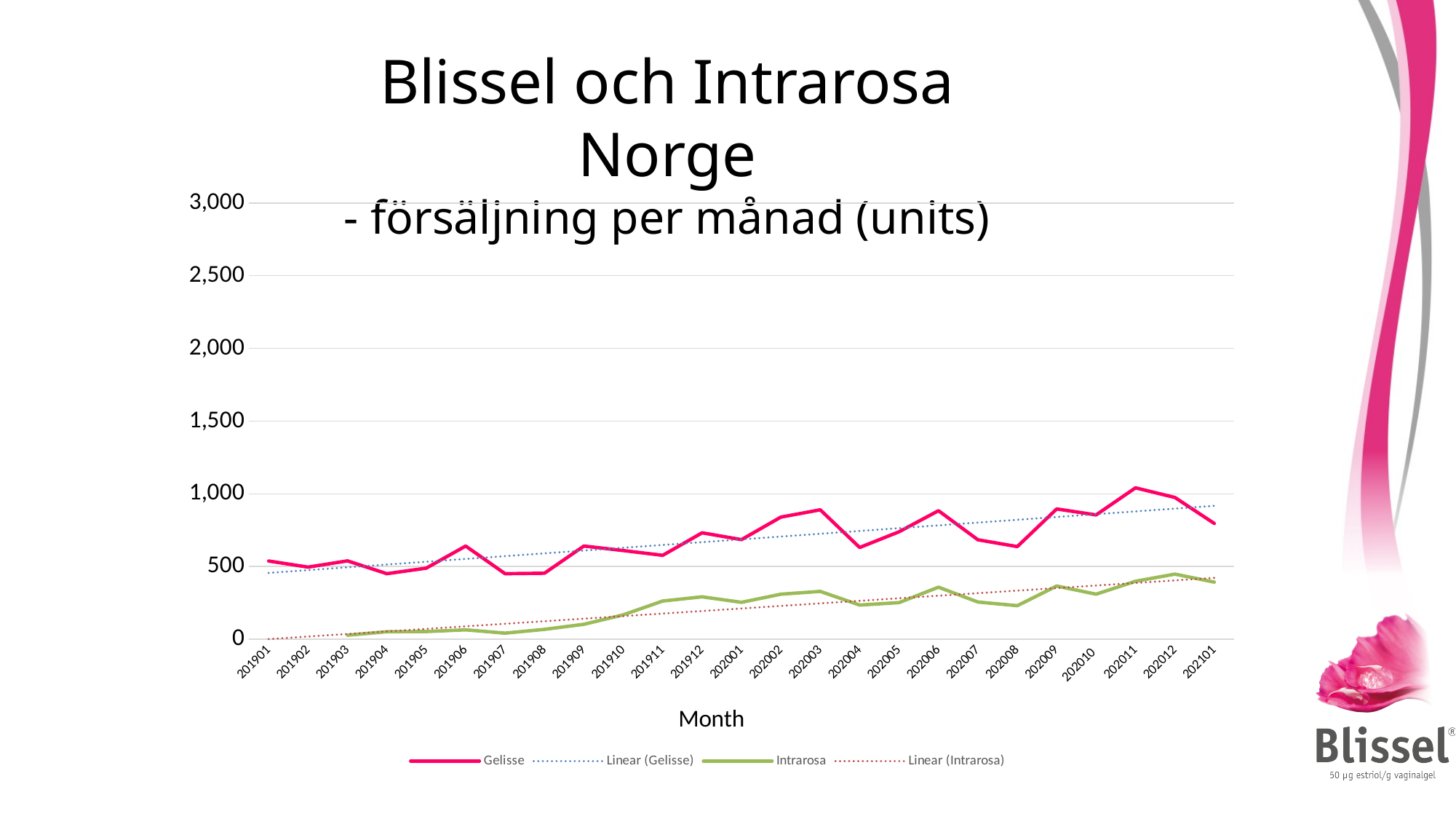
Which colour is used for the Intrarosa line? green Is the value for Intrarosa in 202006 greater or less than 1,000? less What kind of chart is shown on the slide? line chart In 202001, which series has the larger value, Gelisse or Intrarosa? Gelisse In which month does the Gelisse line reach its highest value? 202011 Is the value for Gelisse in 202003 greater or less than 500? greater Is the value for Gelisse in 202011 greater or less than 1,500? less How many months are shown along the x axis of the chart? 25 How many entries does the chart legend list? 4 Overall, does the Gelisse line rise or fall from 201901 to 202101? rise What is the title of the x axis? Month